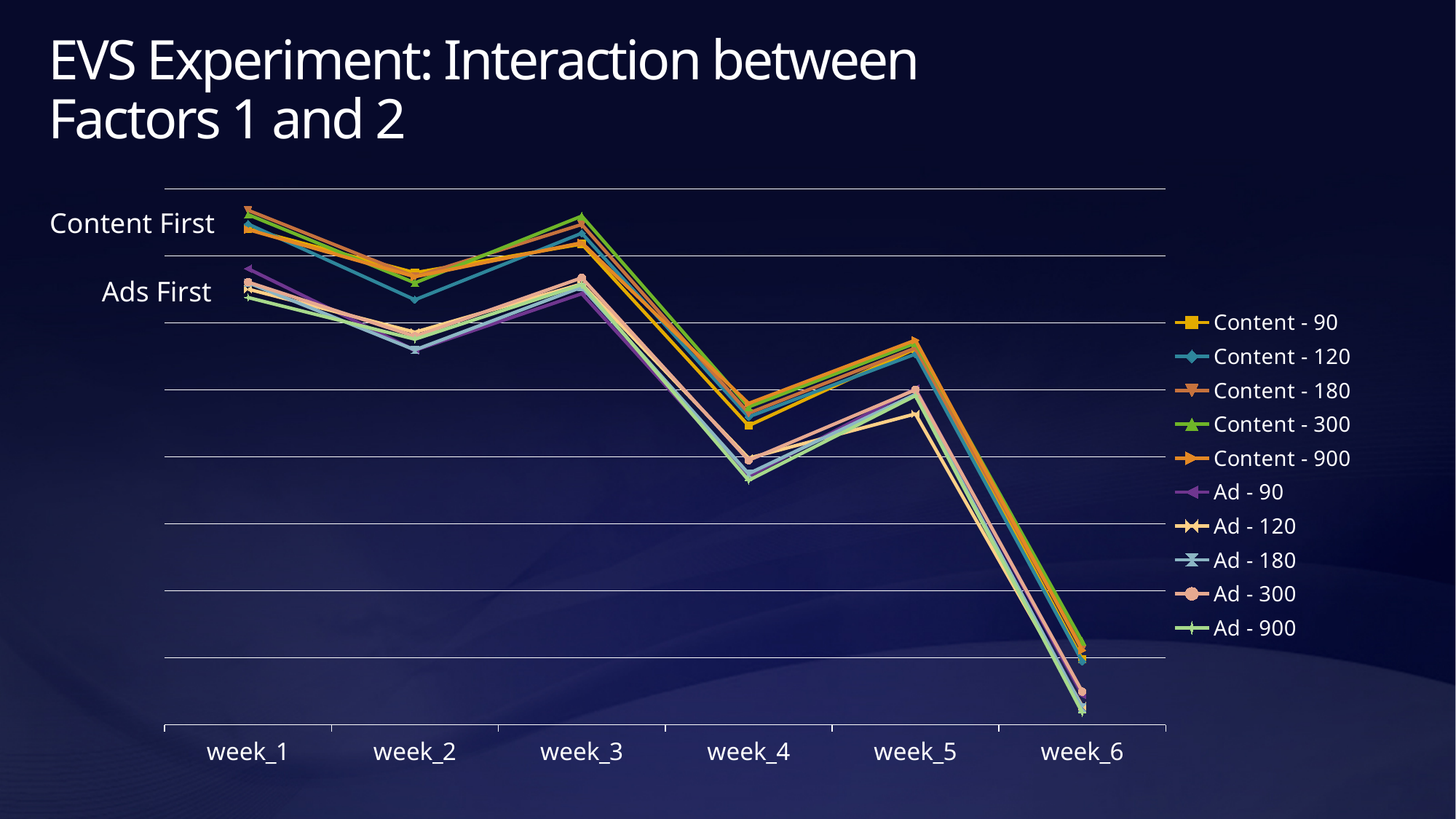
Overall, do the values of the Content - 90 series rise or fall from week_1 to week_6? Fall In which week does the Ad - 900 series reach its lowest value? week_6 What kind of chart is shown on the slide? Line chart How many weeks are shown along the x axis of the chart? 6 Which is larger in week_4: the value for Content - 90 or the value for Ad - 90? Content - 90 Which two group labels are written to the left of the plotted lines? Content First and Ads First Which is larger in week_2: the value for Content - 180 or the value for Ad - 180? Content - 180 Which is larger for the Content - 120 series: the value in week_1 or the value in week_6? week_1 How many series does the chart's legend list? 10 In which week does the Content - 300 series reach its lowest value? week_6 What is the title of the slide containing the chart? EVS Experiment: Interaction between Factors 1 and 2 Between week_4 and week_5, do the values of the Ad - 300 series rise or fall? Rise